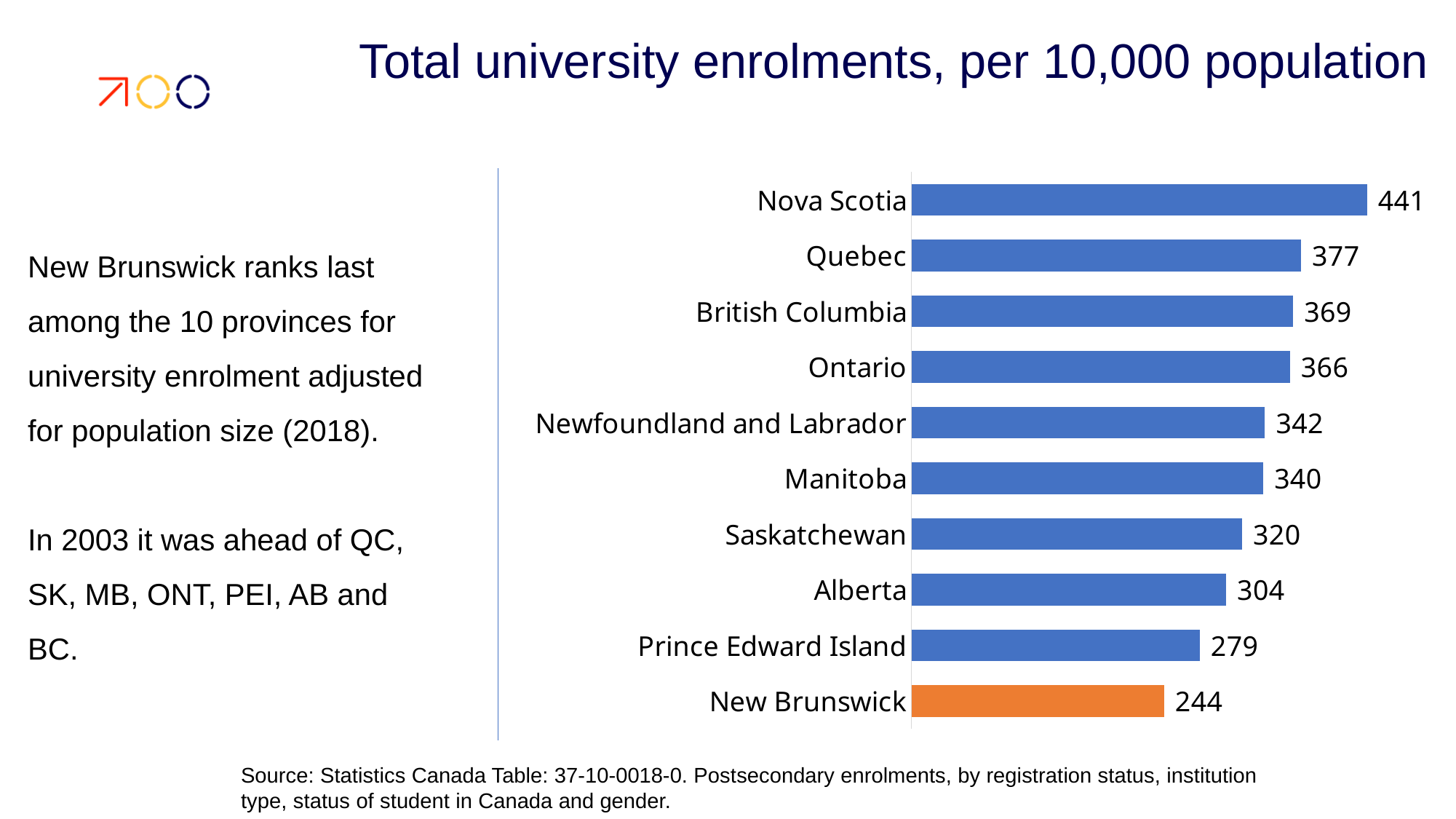
What is the value for Newfoundland and Labrador? 342 Which province has the lowest value? New Brunswick How many provinces are shown in the chart? 10 What is the value for Nova Scotia? 441 What is the difference between the values for Nova Scotia and New Brunswick? 197 Which is larger, the value for Saskatchewan or the value for Alberta? Saskatchewan What is the title of the chart? Total university enrolments, per 10,000 population What is the difference between the values for Quebec and Ontario? 11 Which province's bar is coloured orange instead of blue? New Brunswick What is the value for New Brunswick? 244 What kind of chart is shown on the slide? Bar chart Which province has the highest value? Nova Scotia